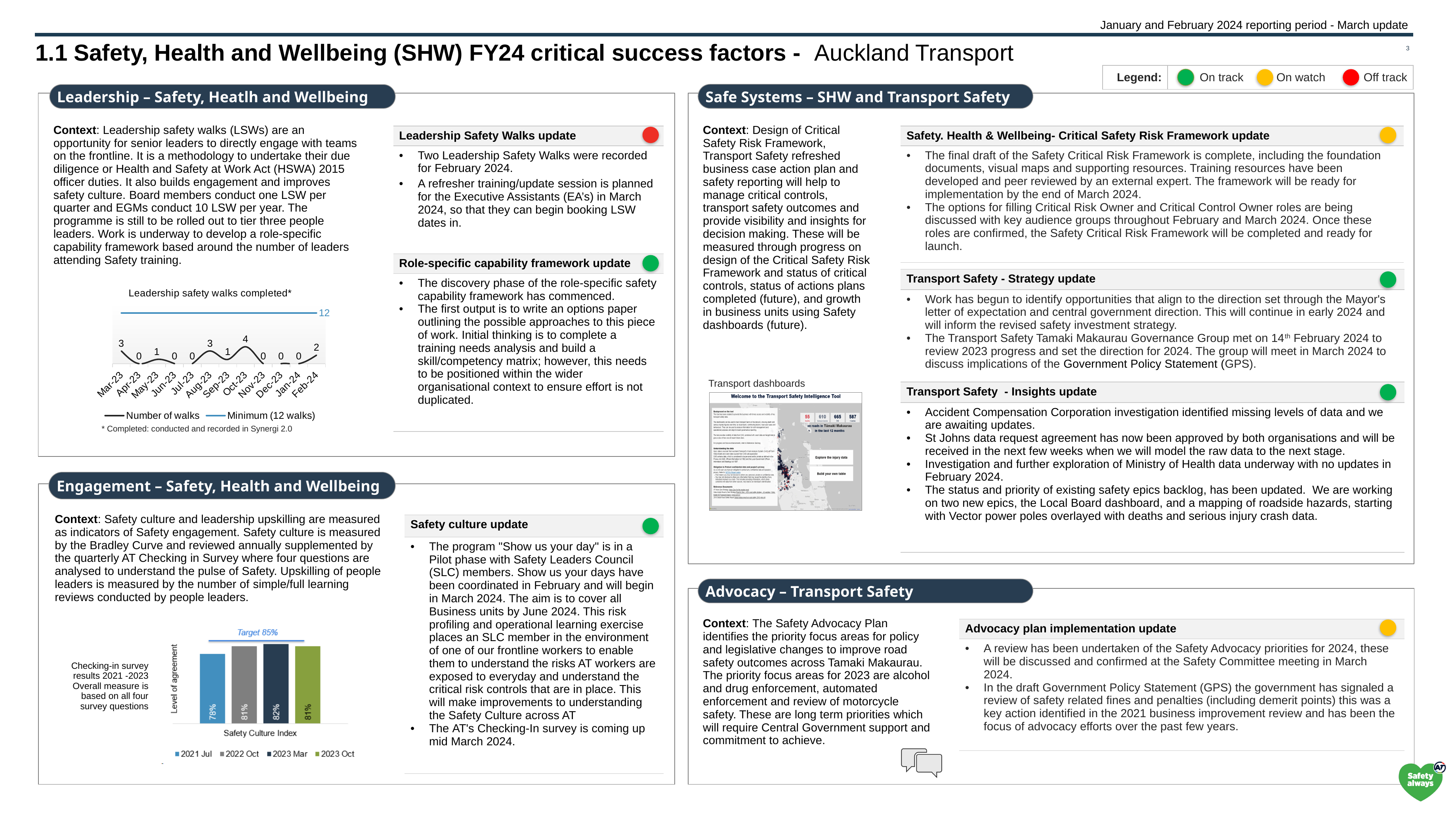
In the 'Leadership safety walks completed*' chart, which month has the highest number of walks? Oct-23 In the 'Safety Culture Index' bar chart, what target value is shown above the bars? Target 85% In the 'Leadership safety walks completed*' chart, what value does the 'Minimum (12 walks)' line sit at? 12 What type of chart is 'Leadership safety walks completed*'? Line chart In the 'Safety Culture Index' bar chart, which survey period has the highest level of agreement? 2023 Mar In the 'Leadership safety walks completed*' chart, how many walks were recorded for Feb-24? 2 In the 'Safety Culture Index' bar chart, what is the value for 2021 Jul? 78% In the 'Leadership safety walks completed*' chart, what is the difference between the number of walks in Oct-23 and Feb-24? 2 In the 'Safety Culture Index' bar chart, what is the difference between the 2023 Mar value and the 2021 Jul value? 4% In the 'Leadership safety walks completed*' chart, how many series does the legend list? 2 In the 'Leadership safety walks completed*' chart, how many walks were recorded for Oct-23? 4 In the 'Leadership safety walks completed*' chart, how many months are plotted on the x axis? 12